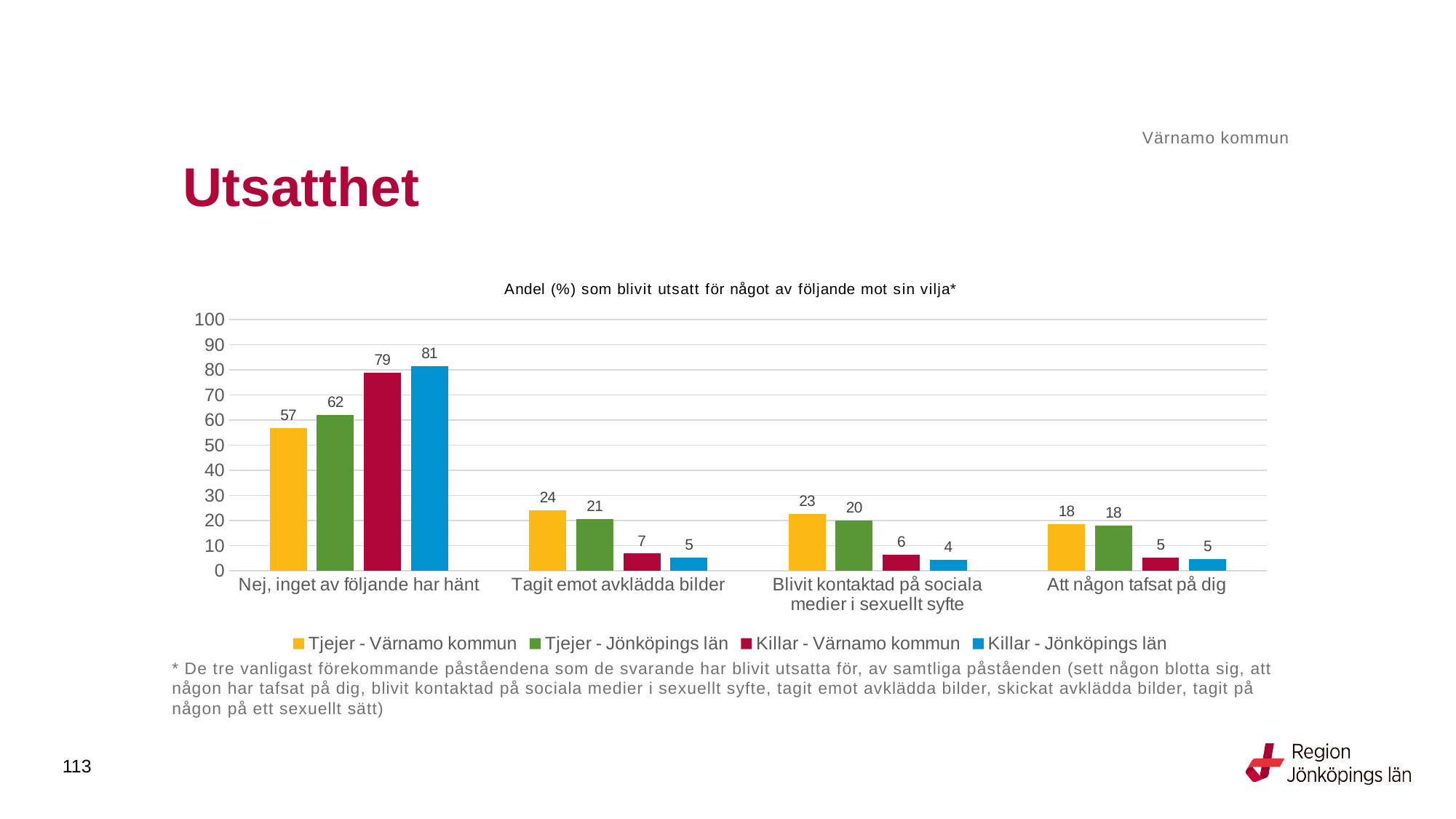
Which series has the lowest value in the category 'Blivit kontaktad på sociala medier i sexuellt syfte'? Killar - Jönköpings län What is the value for Killar - Jönköpings län in the category 'Tagit emot avklädda bilder'? 5 How many categories are shown on the x axis? 4 What kind of chart is shown on the slide? Bar chart What is the value for Killar - Värnamo kommun in the category 'Blivit kontaktad på sociala medier i sexuellt syfte'? 6 What is the value for Tjejer - Värnamo kommun in the category 'Nej, inget av följande har hänt'? 57 Which series has the highest value in the category 'Nej, inget av följande har hänt'? Killar - Jönköpings län How many series does the legend list? 4 Which is larger in the category 'Tagit emot avklädda bilder': Tjejer - Värnamo kommun or Tjejer - Jönköpings län? Tjejer - Värnamo kommun What is the difference between Tjejer - Jönköpings län and Tjejer - Värnamo kommun in the category 'Nej, inget av följande har hänt'? 5 What is the title of the chart? Andel (%) som blivit utsatt för något av följande mot sin vilja* Is the value for Killar - Värnamo kommun in 'Nej, inget av följande har hänt' greater or less than 70? greater